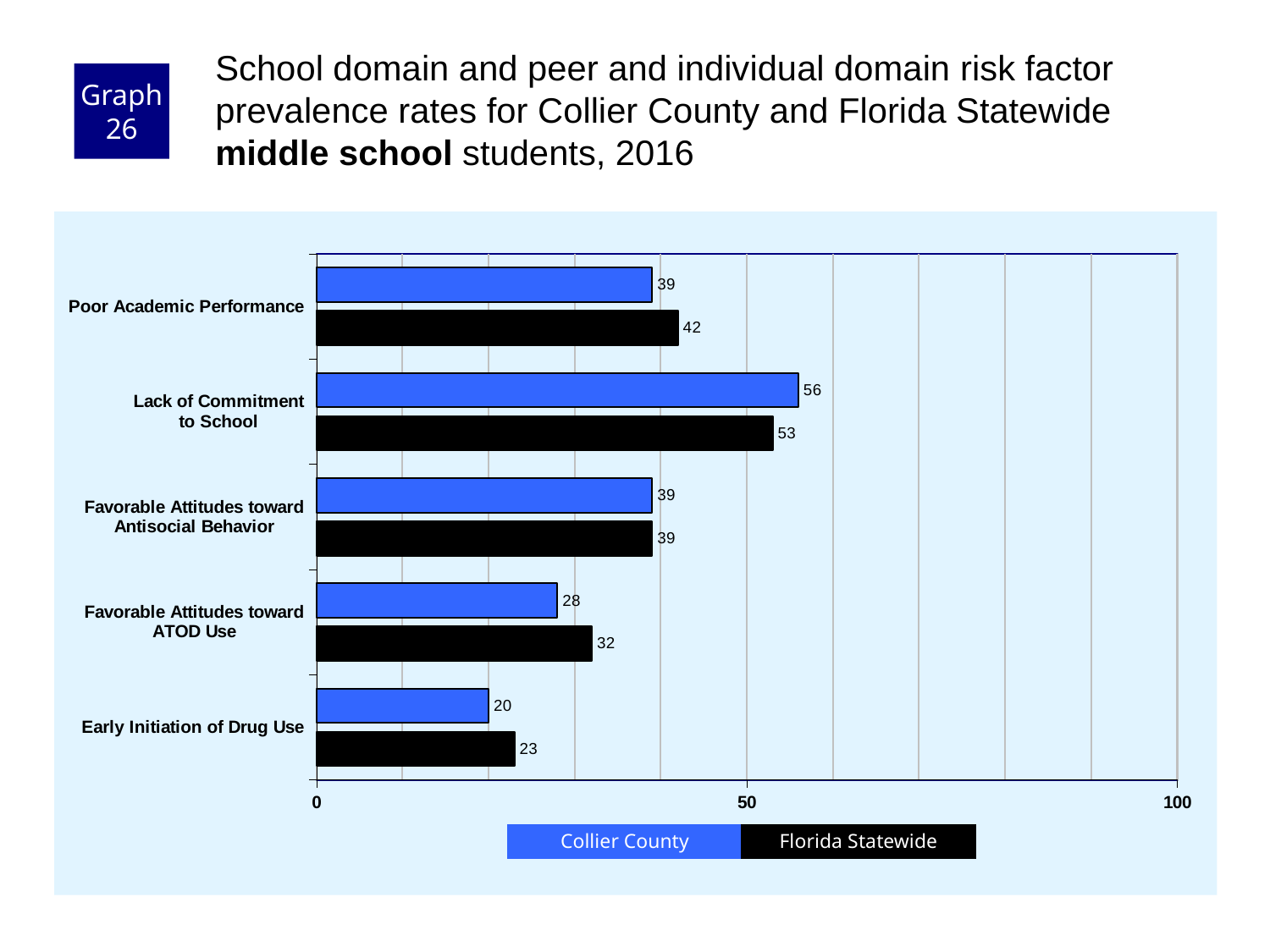
What is the Florida Statewide value for Favorable Attitudes toward ATOD Use? 32 How many series does the legend list? 2 What is the difference between the Florida Statewide and Collier County values for Poor Academic Performance? 3 Which risk factor has the highest Collier County value? Lack of Commitment to School Is the Collier County value for Lack of Commitment to School greater or less than 50? greater Which risk factor has the lowest Florida Statewide value? Early Initiation of Drug Use What is the Florida Statewide value for Early Initiation of Drug Use? 23 What kind of chart is shown on the slide? bar chart Which colour represents Florida Statewide in the chart? black What is the Collier County value for Lack of Commitment to School? 56 How many risk factor categories are shown on the chart? 5 For Lack of Commitment to School, which is larger: the Collier County value or the Florida Statewide value? Collier County